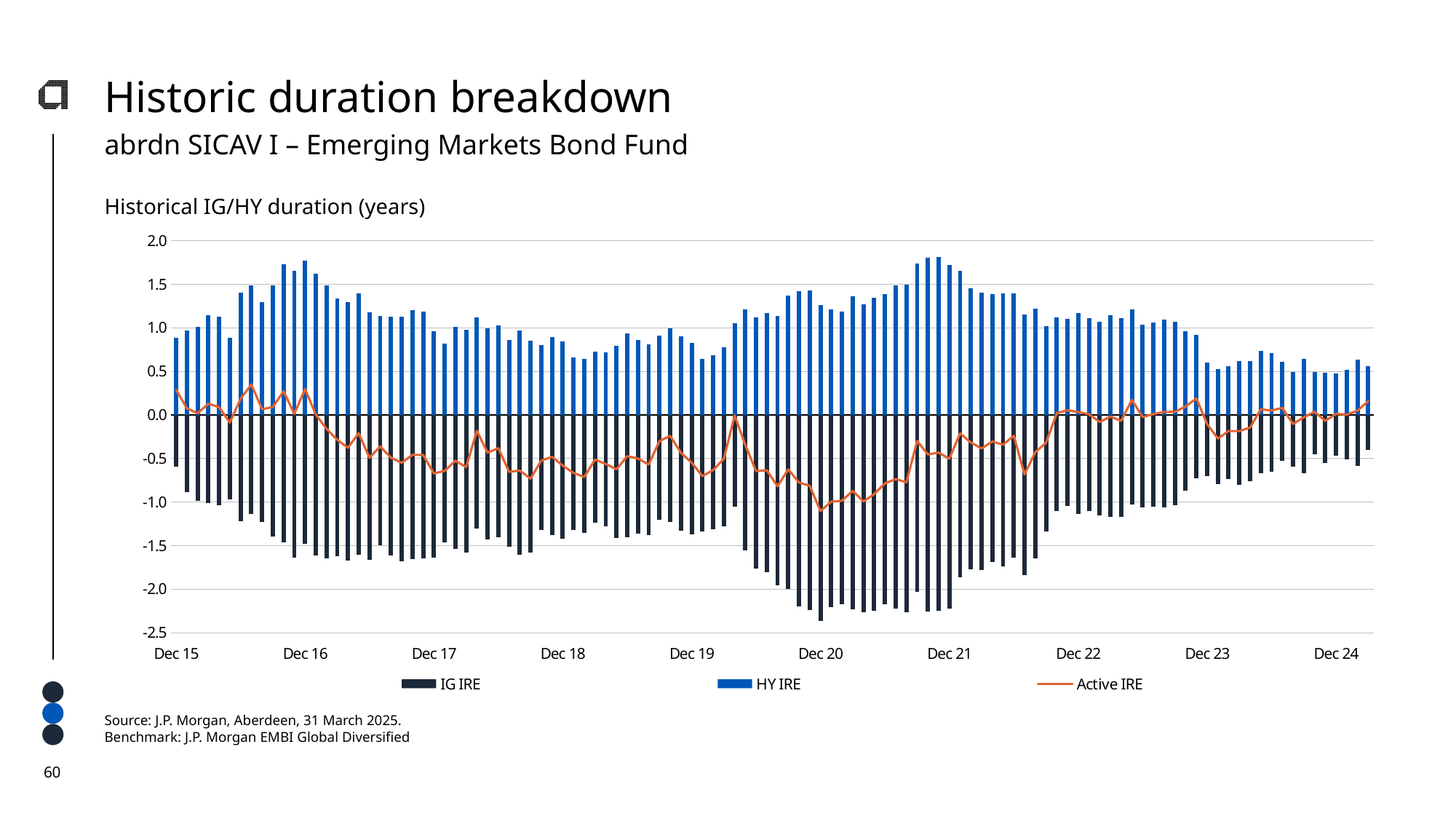
Which series is plotted as a line rather than bars? Active IRE Does the HY IRE series rise or fall between Dec 21 and Dec 24? fall What is the title of the chart? Historical IG/HY duration (years) Is the HY IRE value at Dec 16 greater or less than 1.5? greater How many series does the legend list? 3 How many date labels are shown on the x axis? 10 What kind of chart is this? Combined bar and line chart Is the HY IRE value at Dec 21 greater or less than 1.5? greater Is the Active IRE value at Dec 15 greater or less than 0.0? greater Around which x-axis label does IG IRE reach its most negative value? Dec 20